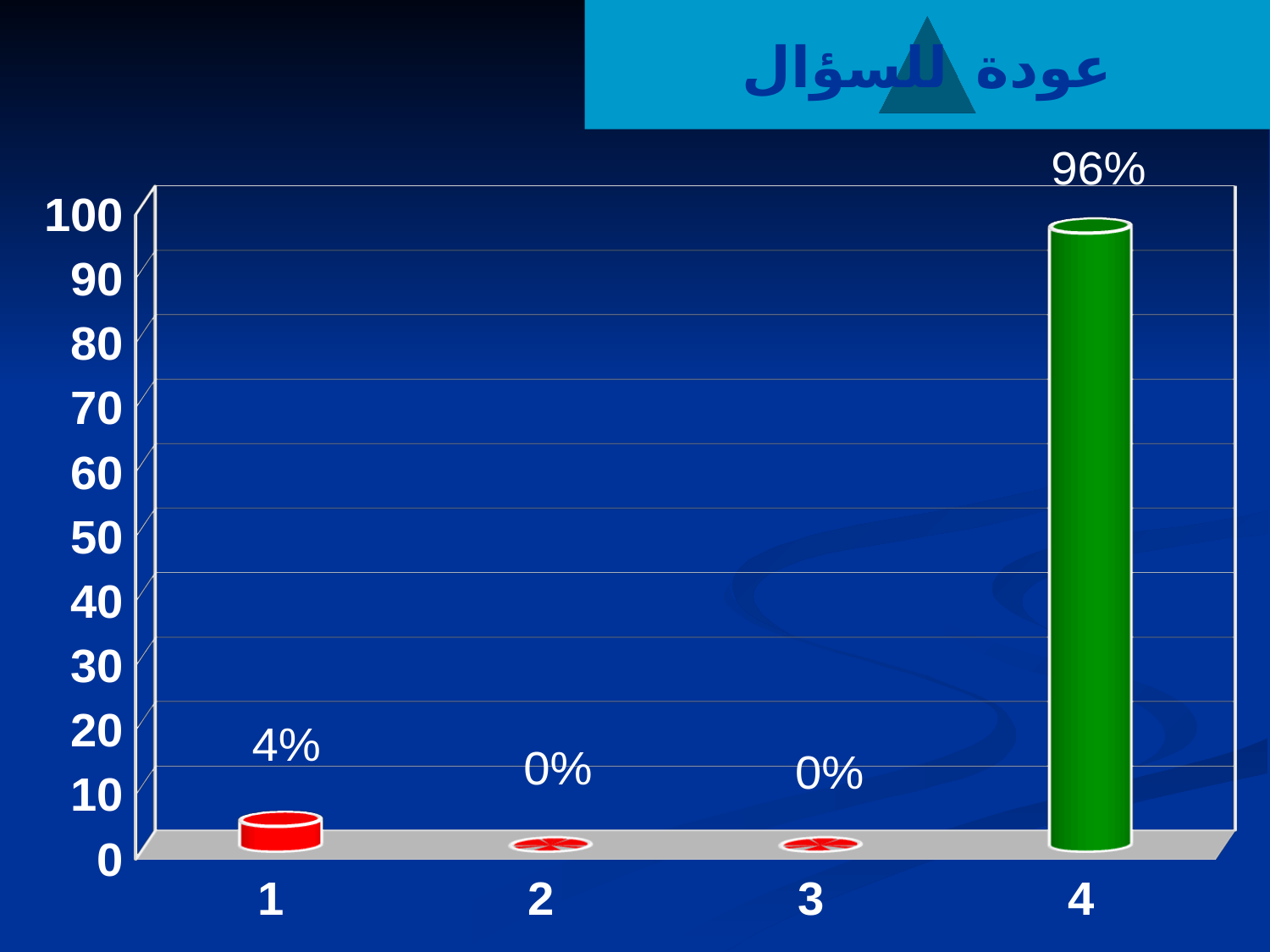
What is the value for category 3? 0% Is the value for category 4 greater or less than 50? greater How many categories are shown on the x axis? 4 What is the value for category 2? 0% What colour is the bar for category 4? green Is the value for category 1 greater or less than 10? less What kind of chart is shown on the slide? bar chart What is the value for category 1? 4% What is the difference between the values for category 4 and category 1? 92% Which category has the highest value? 4 What is the value for category 4? 96% Which is larger, the value for category 1 or the value for category 4? category 4